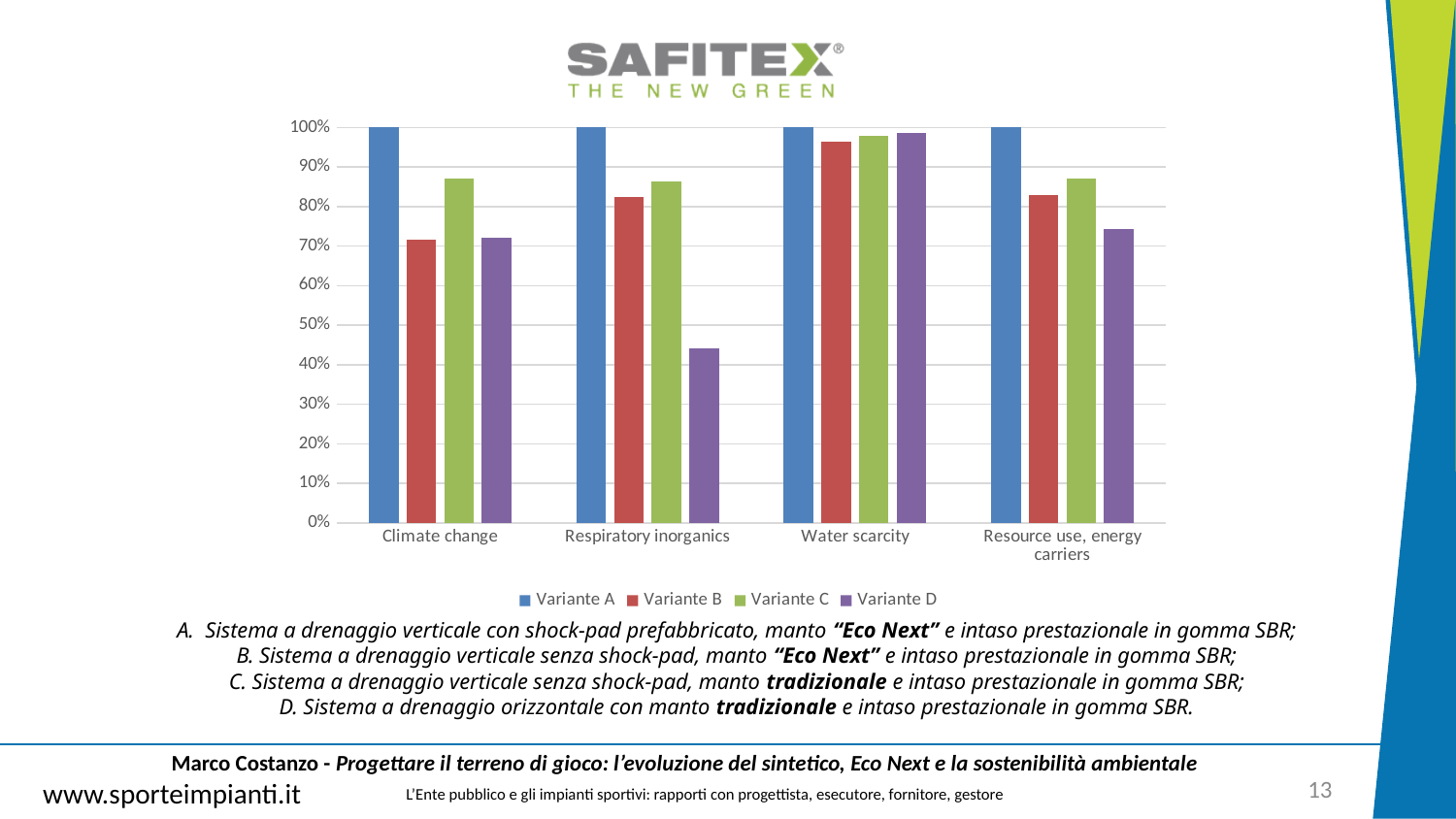
Which series has the lowest value in the Resource use, energy carriers category? Variante D What kind of chart is shown on the slide? bar chart Which series has the lowest value in the Respiratory inorganics category? Variante D Which colour represents Variante A in the chart's legend? blue Which series has the highest value in the Climate change category? Variante A What is the value for Variante A in the Climate change category? 100% Is the value for Variante D in the Respiratory inorganics category greater or less than 50%? less How many series does the chart's legend list? 4 Is the value for Variante C in the Climate change category greater or less than 80%? greater What is the value for Variante A in the Water scarcity category? 100% How many categories are shown on the x axis of the chart? 4 In the Respiratory inorganics category, which is larger: Variante C or Variante D? Variante C